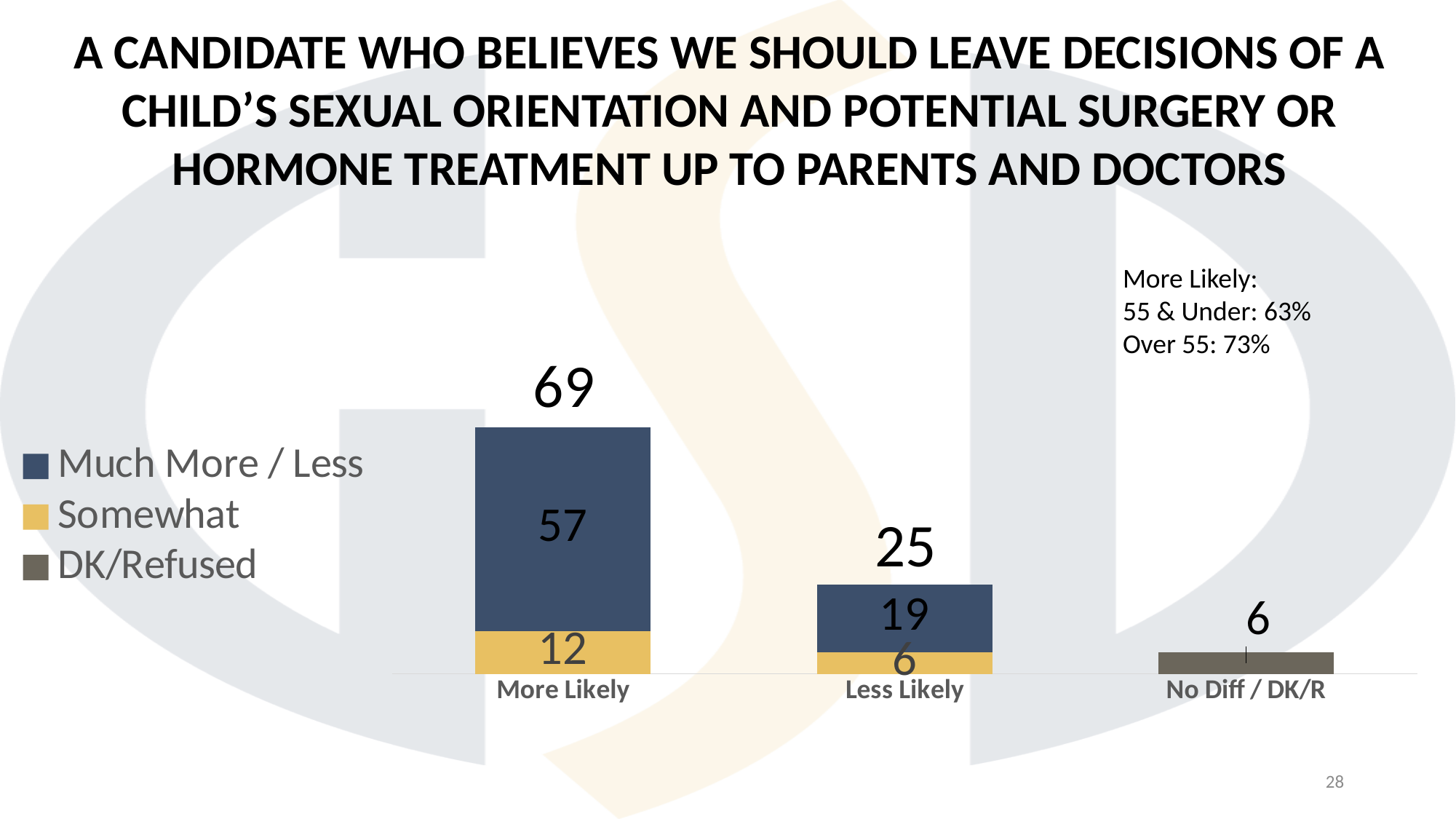
How many series does the legend list? 3 What is the total shown above the More Likely bar? 69 What is the 'Much More / Less' value for the Less Likely bar? 19 What kind of chart is shown on the slide? Stacked bar chart What is the 'Somewhat' value for the Less Likely bar? 6 What is the 'Much More / Less' value for the More Likely bar? 57 What is the difference between the More Likely total and the Less Likely total? 44 Is the 'Much More / Less' value larger for More Likely or Less Likely? More Likely What is the total shown above the Less Likely bar? 25 Which category has the lowest total? No Diff / DK/R What is the 'Somewhat' value for the More Likely bar? 12 Which category has the highest total? More Likely